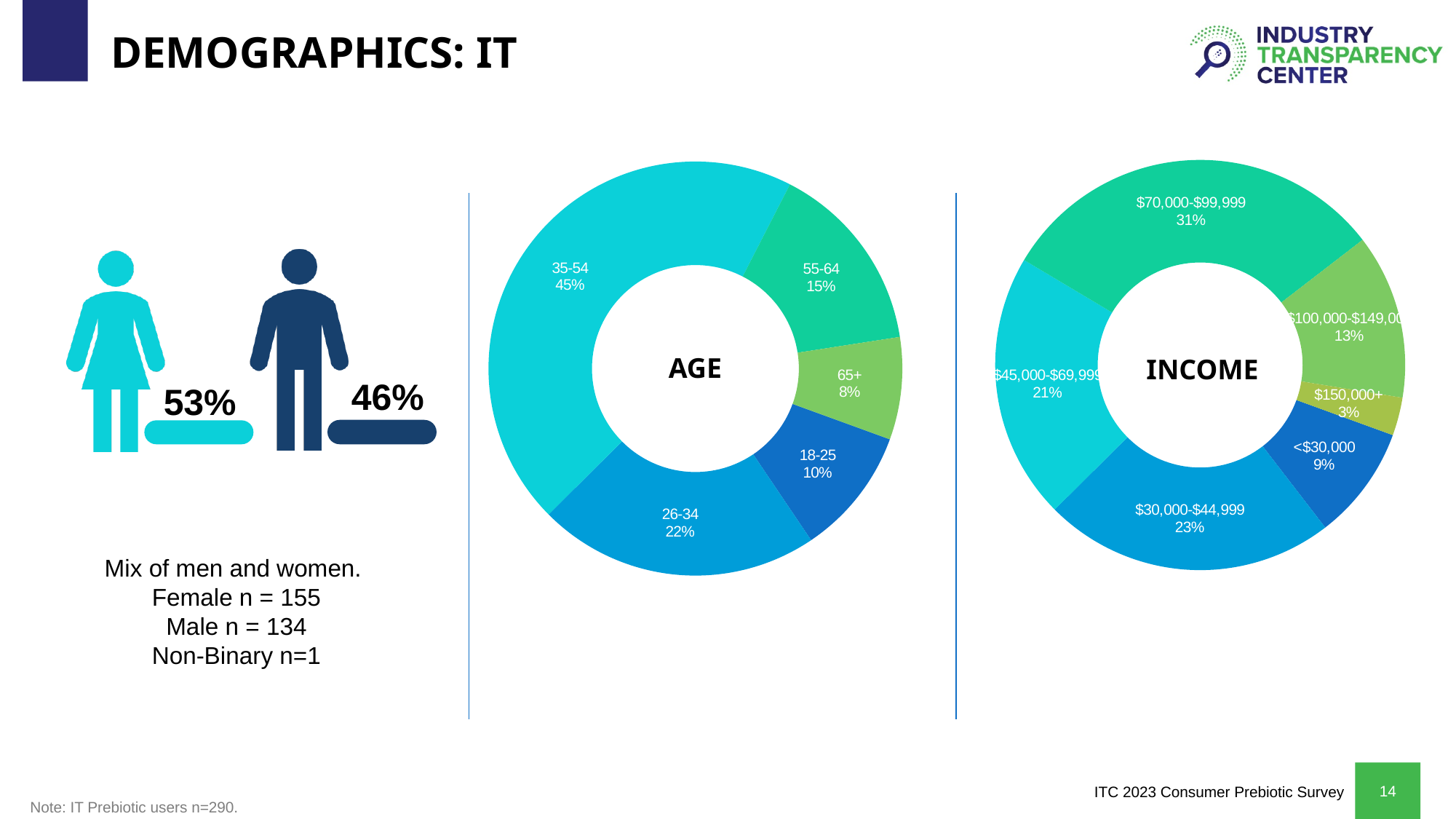
What kind of chart is the AGE chart? Donut (pie) chart In the AGE chart, what percentage is shown for the 26-34 group? 22% In the AGE chart, what share of respondents are aged 35-54? 45% In the INCOME chart, what percentage is shown for $30,000-$44,999? 23% How many income brackets are shown in the INCOME chart? 6 How many age groups are shown in the AGE chart? 5 In the INCOME chart, what share of respondents earn $70,000-$99,999? 31% In the AGE chart, which age group has the largest share? 35-54 In the AGE chart, which age group has the smallest share? 65+ In the INCOME chart, which income bracket has the smallest share? $150,000+ In the INCOME chart, which is larger: the share for $45,000-$69,999 or the share for <$30,000? $45,000-$69,999 In the AGE chart, what is the difference in percentage points between the 55-64 and 18-25 groups? 5